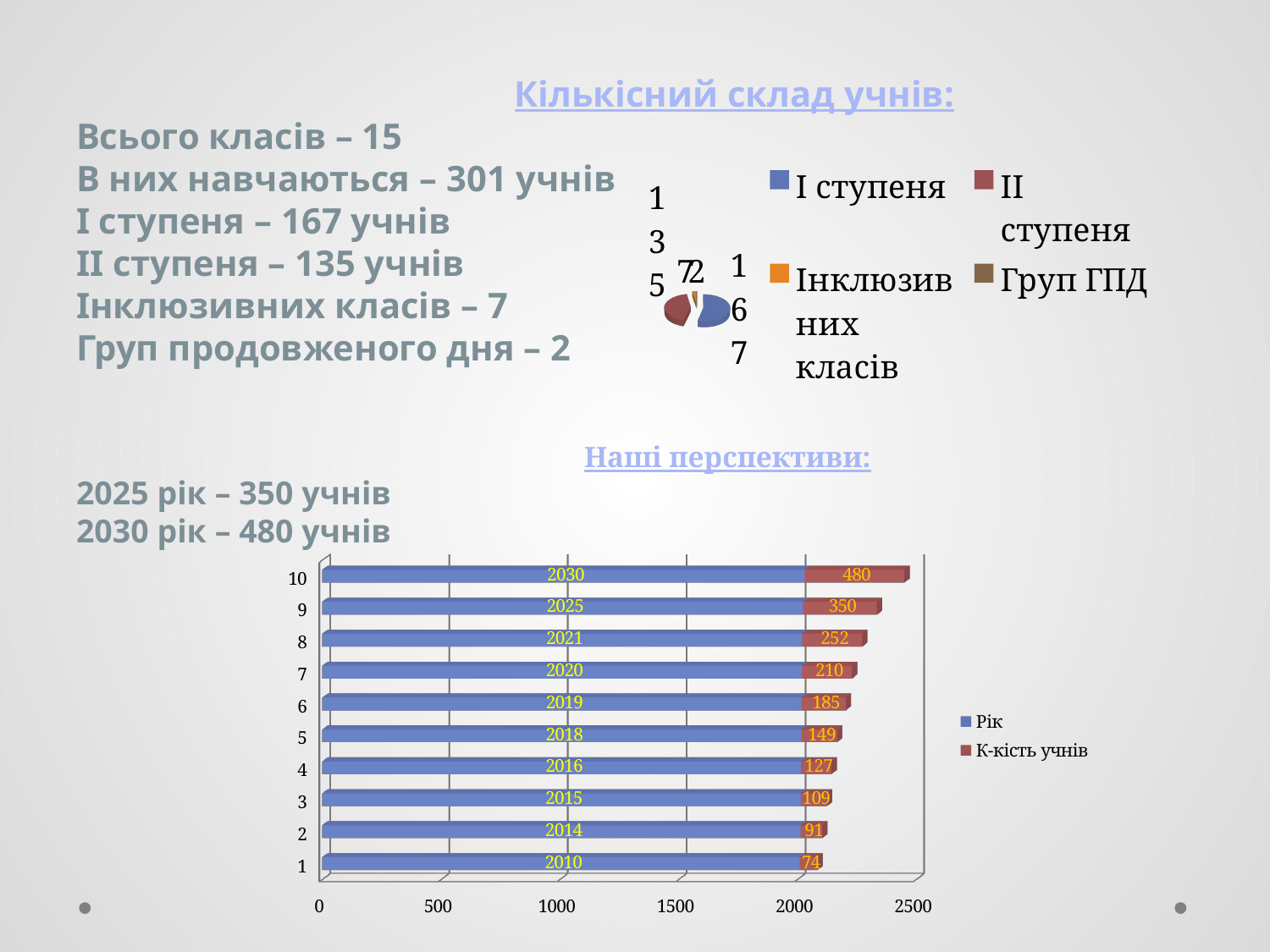
In the bottom bar chart, do the "К-кість учнів" values rise or fall from category 1 to category 10? rise How many categories are shown in the bottom bar chart? 10 In the bottom bar chart, what is the value of the "Рік" series for category 1? 2010 What type of chart is the bottom chart titled "Наші перспективи:"? bar chart In the bottom bar chart, which category has the highest "К-кість учнів" value? 10 In the bottom bar chart, what is the value of the "К-кість учнів" series for category 10? 480 In the bottom bar chart, what is the value of the "К-кість учнів" series for category 5? 149 How many entries does the legend of the pie chart at the top of the slide list? 4 In the bottom bar chart, what is the total of the stacked bar for category 10? 2510 How many series does the legend of the bottom bar chart list? 2 In the bottom bar chart, what is the difference between the "К-кість учнів" values for category 10 and category 9? 130 In the bottom bar chart, which category has the lowest "К-кість учнів" value? 1